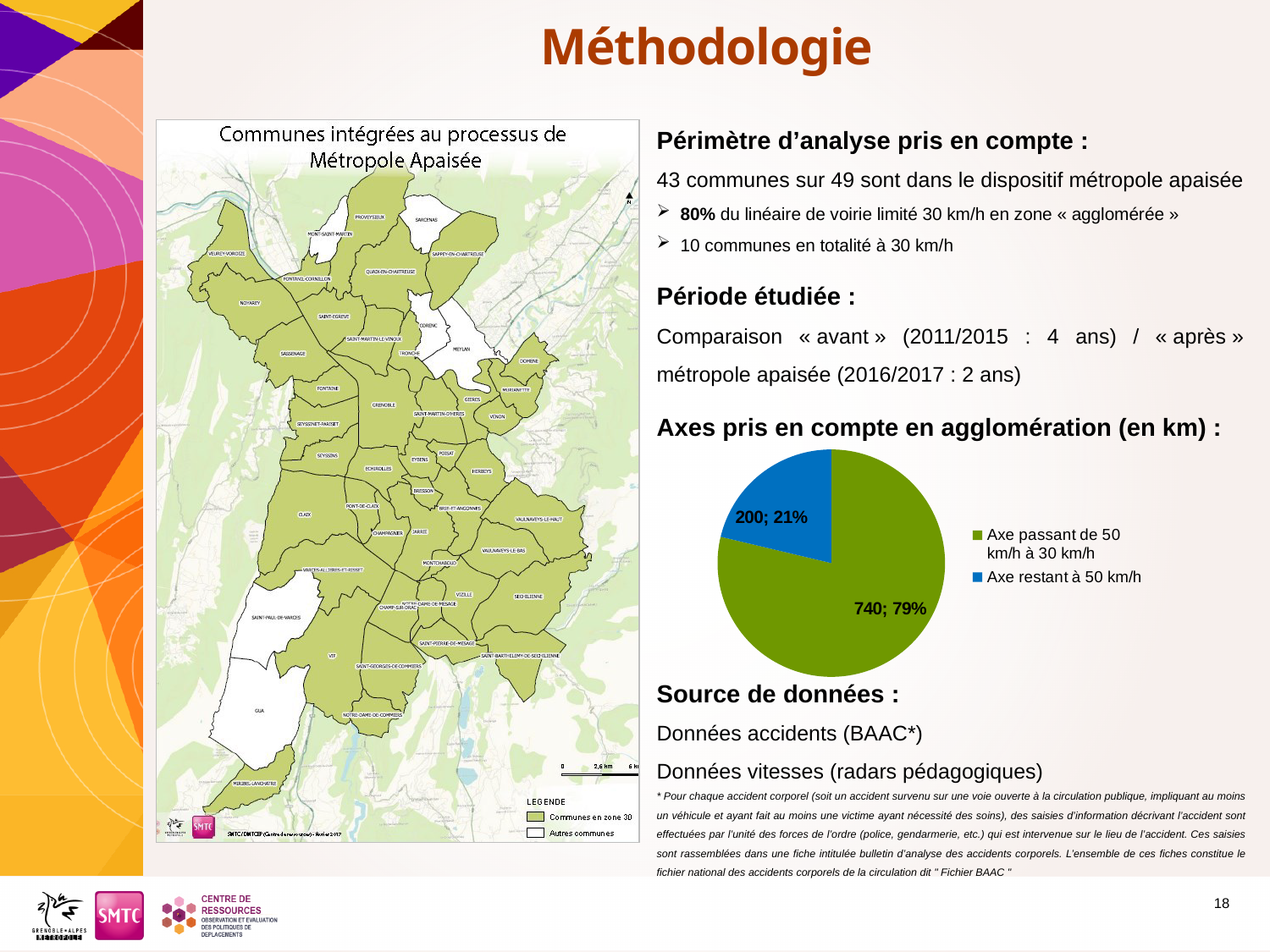
In the pie chart, what percentage share does "Axe passant de 50 km/h à 30 km/h" have? 79% In the pie chart, what colour is the slice for "Axe restant à 50 km/h"? blue What is the total in km of the two slices in the pie chart? 940 What kind of chart is shown under "Axes pris en compte en agglomération (en km)"? pie chart Which slice of the pie chart is the smallest? Axe restant à 50 km/h Which slice of the pie chart is the largest? Axe passant de 50 km/h à 30 km/h How many slices does the pie chart have? 2 In the pie chart, what percentage share does "Axe restant à 50 km/h" have? 21% In the pie chart, what value in km is shown for "Axe restant à 50 km/h"? 200 In the pie chart, what is the difference in km between "Axe passant de 50 km/h à 30 km/h" and "Axe restant à 50 km/h"? 540 In the pie chart, what value in km is shown for "Axe passant de 50 km/h à 30 km/h"? 740 In the pie chart, which is larger: "Axe passant de 50 km/h à 30 km/h" or "Axe restant à 50 km/h"? Axe passant de 50 km/h à 30 km/h